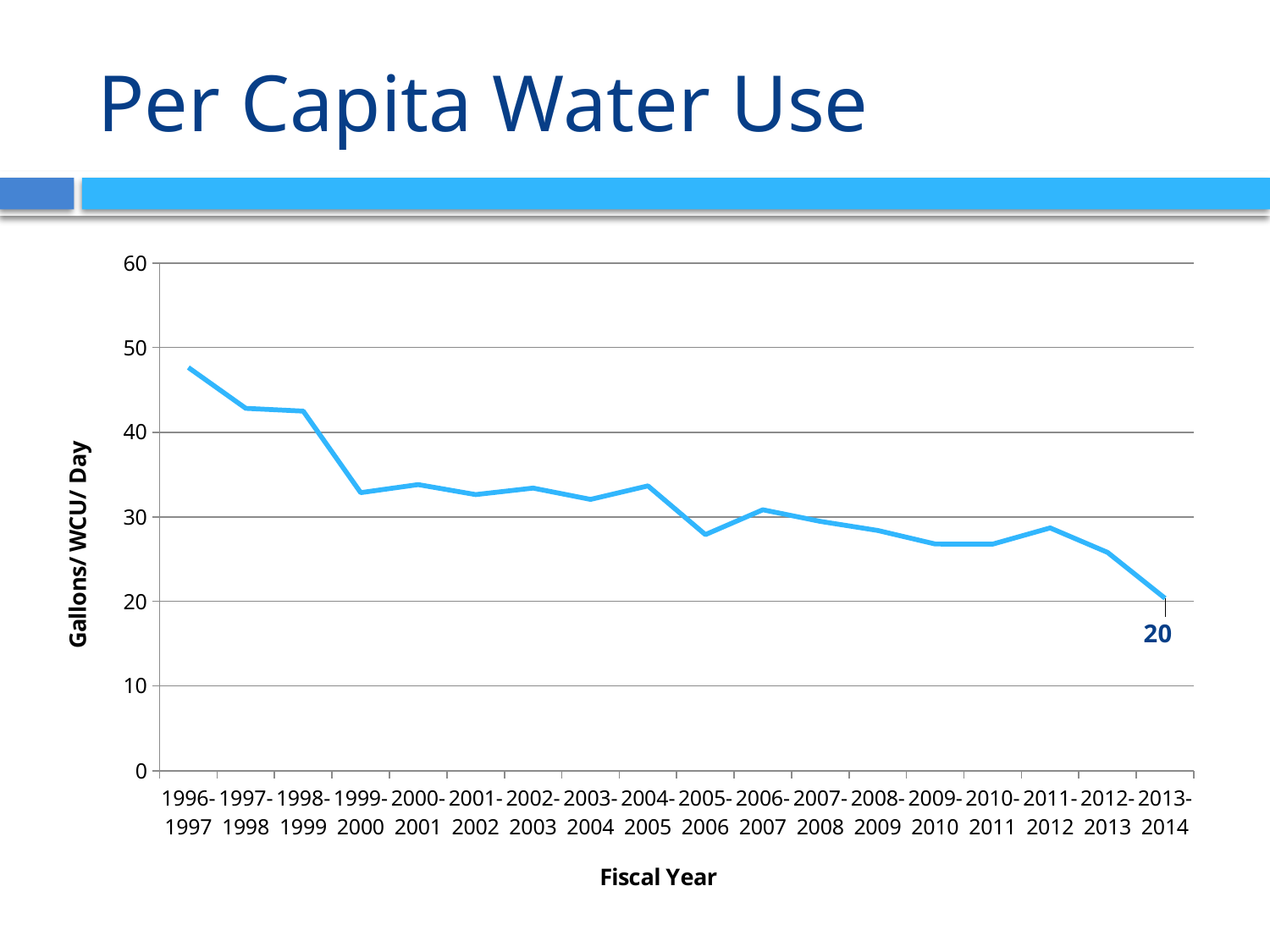
Which fiscal year has the lowest per capita water use? 2013-2014 How many fiscal years are plotted on the x axis? 18 Which fiscal year has the highest per capita water use? 1996-1997 What is the per capita water use value shown for fiscal year 2013-2014? 20 Which is larger, the value for 1996-1997 or the value for 1999-2000? 1996-1997 Do the values generally rise or fall from 1996-1997 to 2013-2014? fall What is the title of the y axis? Gallons/ WCU/ Day What is the title of the x axis? Fiscal Year What kind of chart is shown on the slide? line chart Is the value for 1999-2000 greater or less than 30? greater Is the value for 2005-2006 greater or less than 30? less Is the value for 1996-1997 greater or less than 40? greater